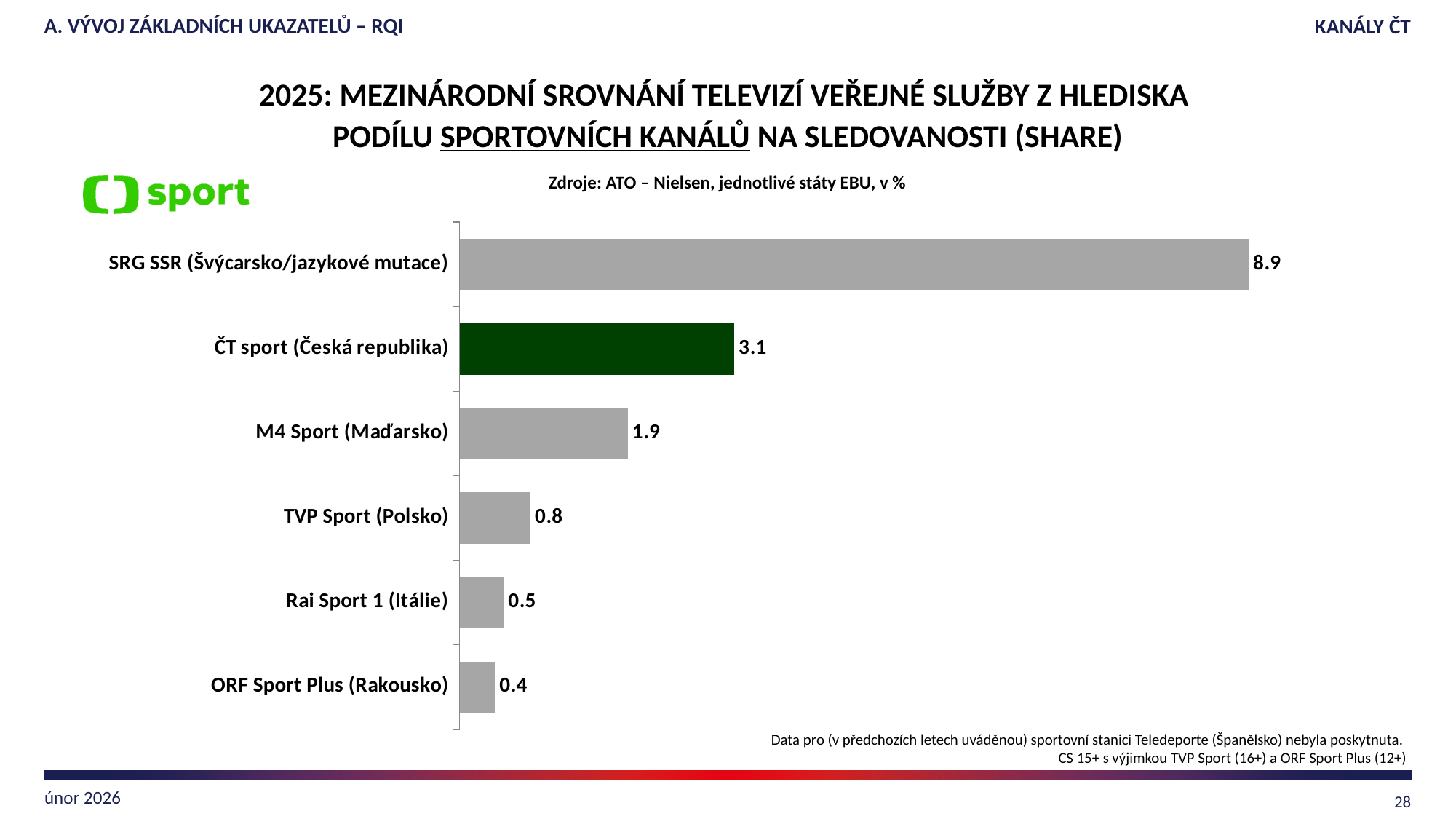
How many categories are shown in the chart? 6 What is the value for SRG SSR (Švýcarsko/jazykové mutace)? 8.9 What is the difference between the values for SRG SSR (Švýcarsko/jazykové mutace) and ČT sport (Česká republika)? 5.8 What is the value for TVP Sport (Polsko)? 0.8 What is the difference between the values for M4 Sport (Maďarsko) and Rai Sport 1 (Itálie)? 1.4 Which category has the highest value? SRG SSR (Švýcarsko/jazykové mutace) Which bar is coloured dark green instead of grey? ČT sport (Česká republika) What is the value for ORF Sport Plus (Rakousko)? 0.4 Which category has the lowest value? ORF Sport Plus (Rakousko) What is the value for ČT sport (Česká republika)? 3.1 What kind of chart is shown on the slide? bar chart Which is larger, the value for M4 Sport (Maďarsko) or the value for TVP Sport (Polsko)? M4 Sport (Maďarsko)